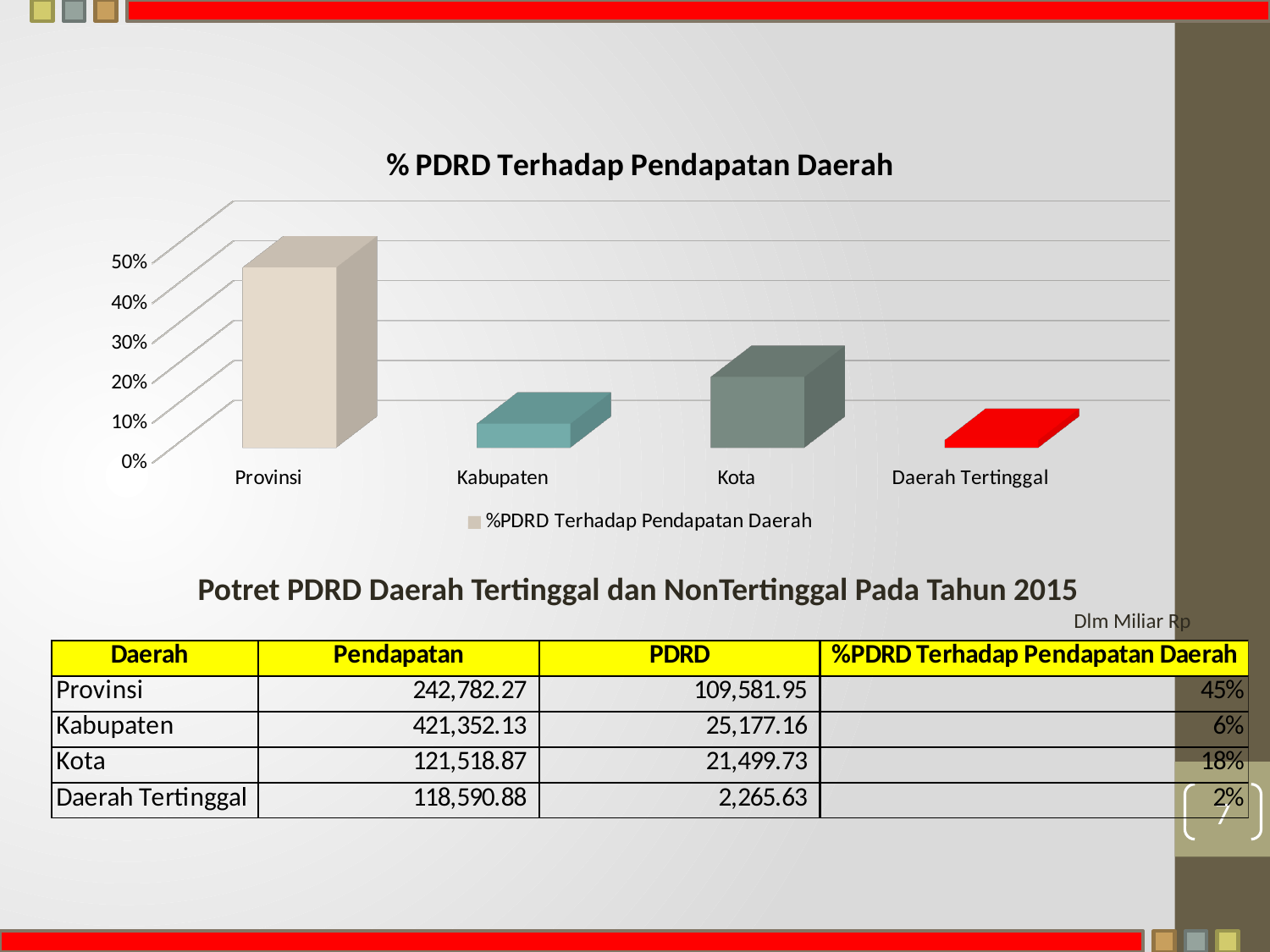
Which category has the lowest % PDRD Terhadap Pendapatan Daerah? Daerah Tertinggal What kind of chart is shown on the slide? bar chart Which category has the highest % PDRD Terhadap Pendapatan Daerah? Provinsi Is the value for Provinsi greater or less than 40%? greater Which has a larger % PDRD Terhadap Pendapatan Daerah, Kota or Kabupaten? Kota How many series does the chart legend list? 1 According to the slide, what is the % PDRD Terhadap Pendapatan Daerah for Kota? 18% Is the value for Kabupaten greater or less than 10%? less Is the value for Kota greater or less than 20%? less How many categories are plotted on the x axis of the chart? 4 What is the title of the chart? % PDRD Terhadap Pendapatan Daerah According to the slide, what is the difference between the % PDRD Terhadap Pendapatan Daerah for Provinsi and for Kabupaten? 39%